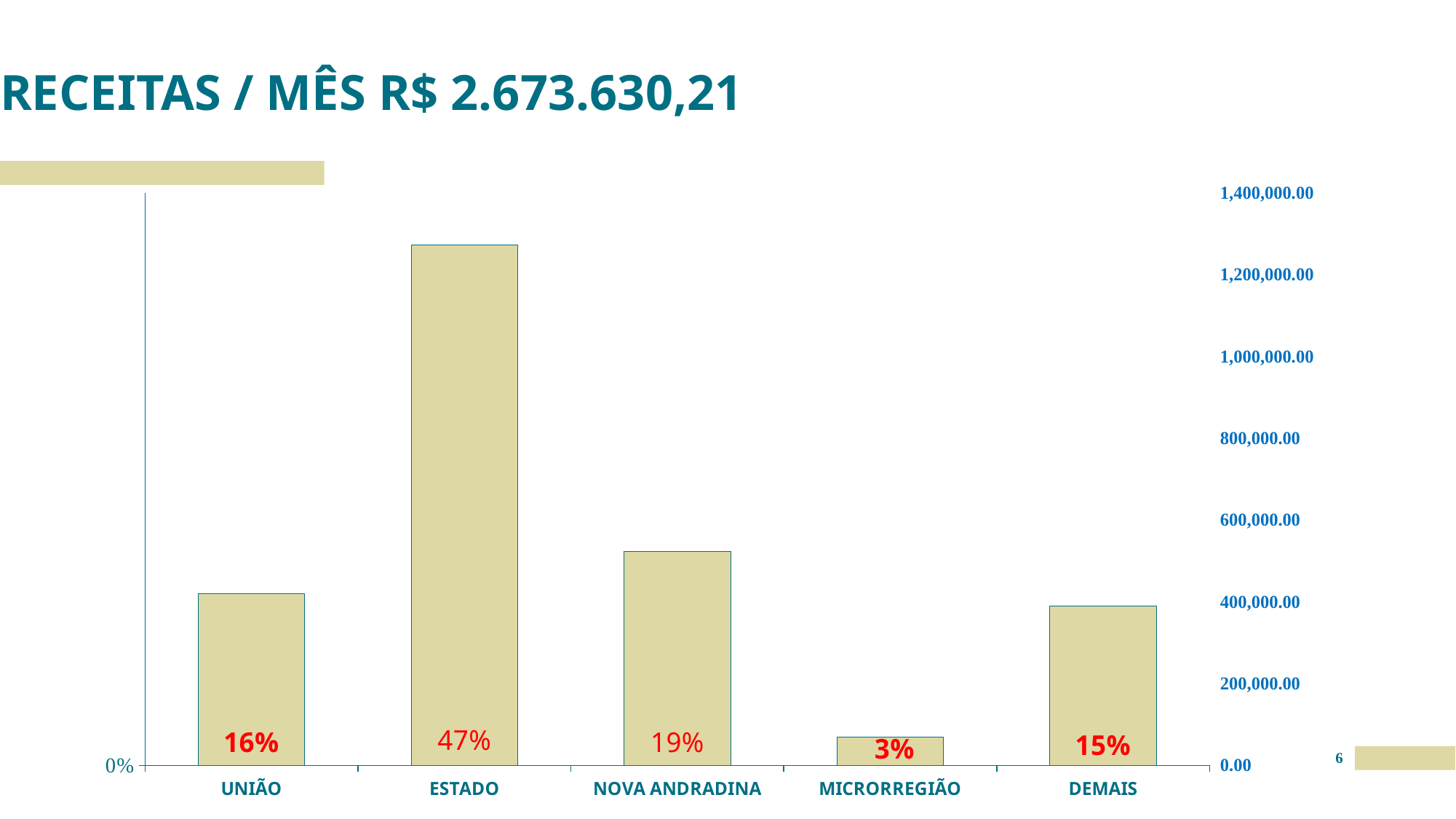
Is the value for ESTADO on the right-hand axis greater or less than 1,200,000.00? greater Which is larger, the bar for NOVA ANDRADINA or the bar for DEMAIS? NOVA ANDRADINA What is the difference in percentage points between the ESTADO and NOVA ANDRADINA labels? 28 What percentage label is shown on the UNIÃO bar? 16% Is the value for MICRORREGIÃO on the right-hand axis greater or less than 200,000.00? less What kind of chart is shown on the slide? bar chart Which category has the highest bar? ESTADO What percentage label is shown on the DEMAIS bar? 15% Which category has the lowest bar? MICRORREGIÃO What percentage label is shown on the ESTADO bar? 47% How many categories are shown on the x axis? 5 What percentage label is shown on the MICRORREGIÃO bar? 3%